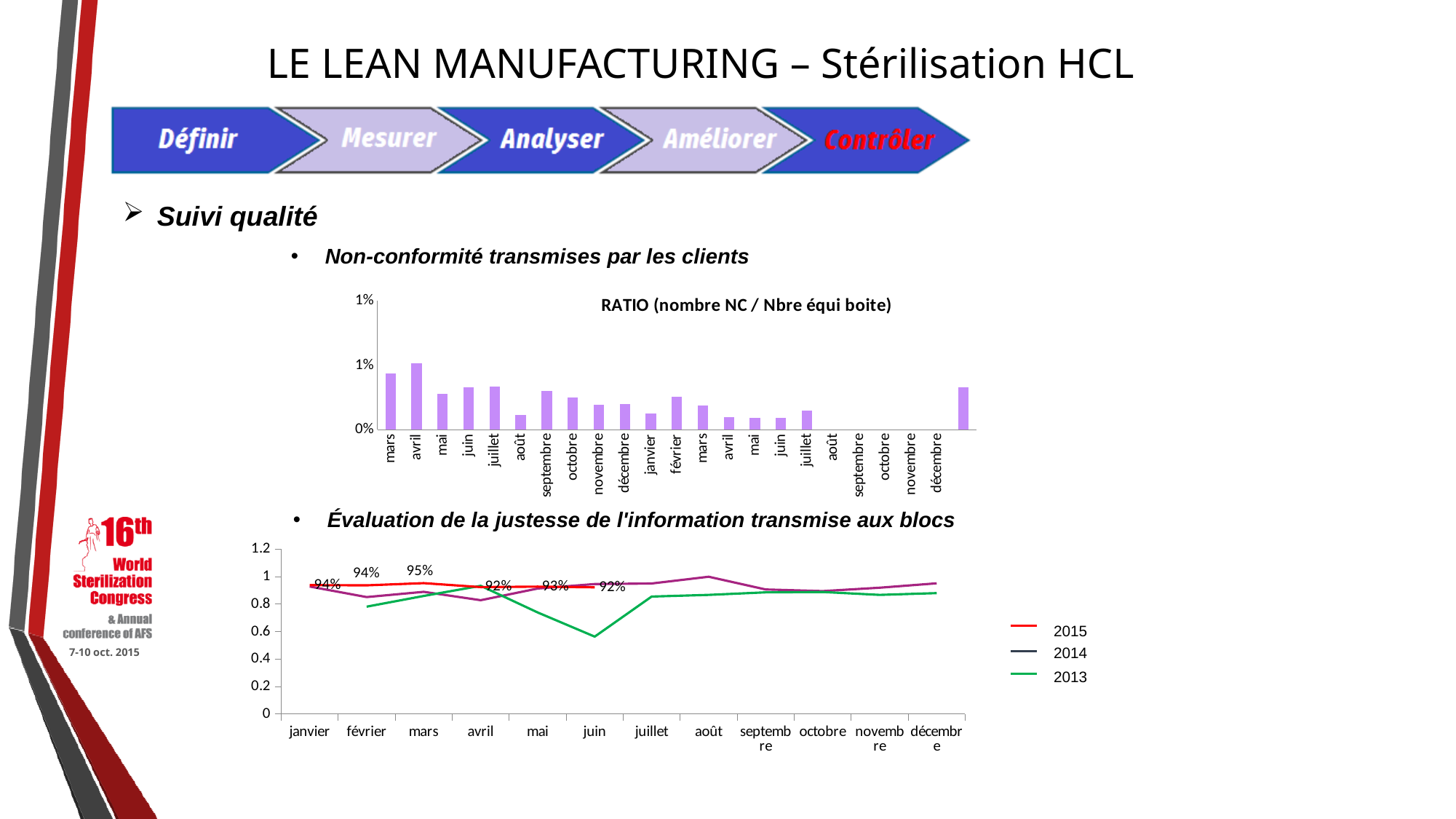
In the bottom line chart, which is larger: the 2015 value for février or for avril? février In the bottom line chart, is the 2013 value for juin greater or less than 0.8? less In the bottom line chart, what is the difference between the 2015 values for mars and juin? 3% What kind of chart is the bottom chart under 'Évaluation de la justesse de l'information transmise aux blocs'? line chart In the bottom line chart, what is the labelled value for 2015 in janvier? 94% In the top chart 'RATIO (nombre NC / Nbre équi boite)', which month has the tallest bar? avril In the bottom line chart, how many series does the legend list? 3 In the bottom line chart, how many months are shown on the x axis? 12 In the bottom line chart, what is the labelled value for 2015 in mars? 95% What kind of chart is the top chart titled 'RATIO (nombre NC / Nbre équi boite)'? bar chart In the bottom line chart, which month has the highest labelled value for 2015? mars In the bottom line chart, what is the labelled value for 2015 in mai? 93%